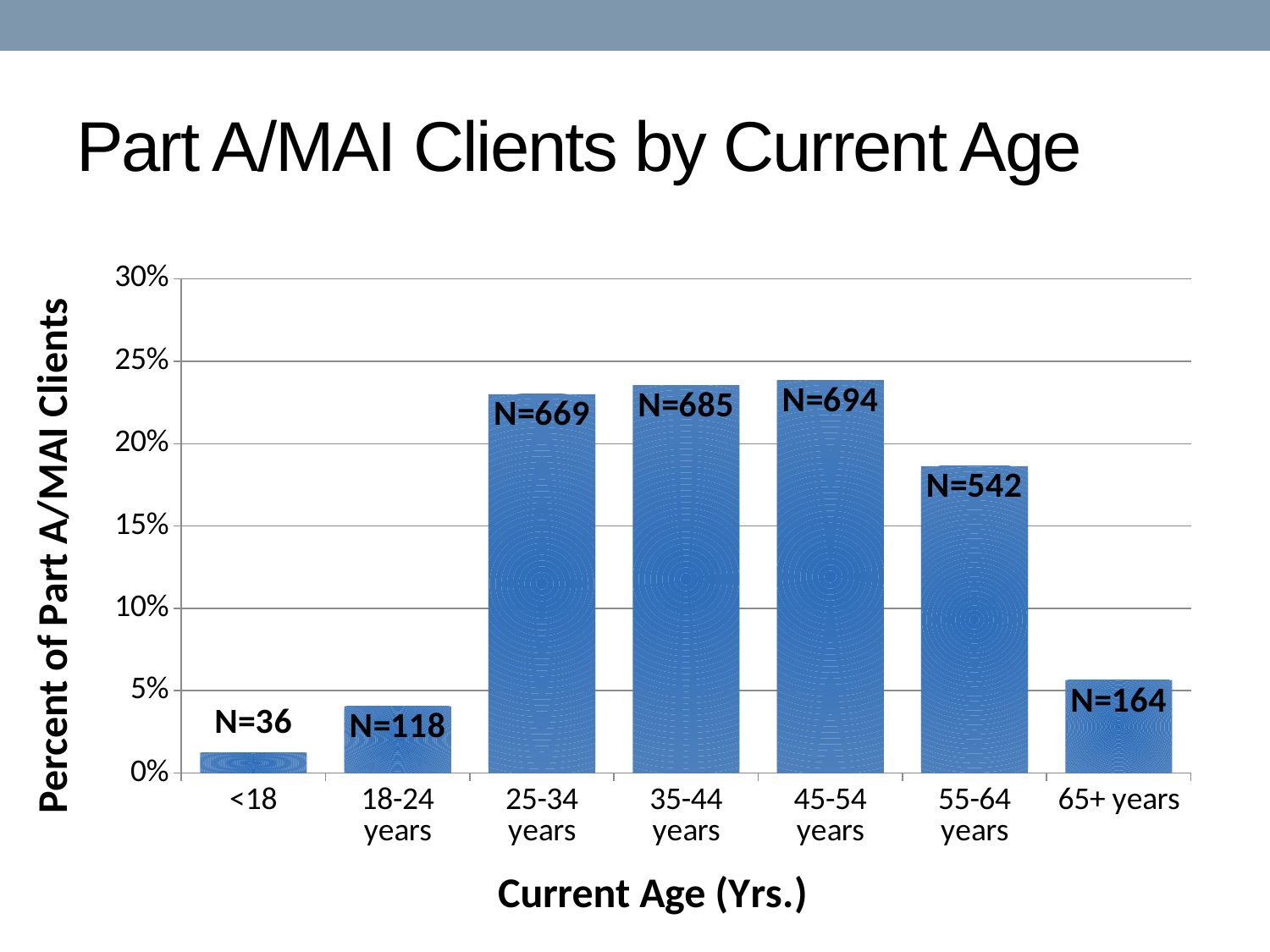
Is the percent of clients aged 25-34 years greater or less than 20%? greater Which age group has the largest N value? 45-54 years Is the percent of clients aged 55-64 years greater or less than 20%? less How many age groups are shown on the x axis? 7 Which age group has the smallest N value? <18 What is the N value shown for the <18 age group? N=36 What kind of chart is shown on the slide? Bar chart What is the label of the y axis? Percent of Part A/MAI Clients What is the N value shown for the 25-34 years age group? N=669 What is the N value shown for the 55-64 years age group? N=542 Which age group has a larger N value, 18-24 years or 65+ years? 65+ years What is the difference between the N values for the 45-54 years and 35-44 years age groups? 9